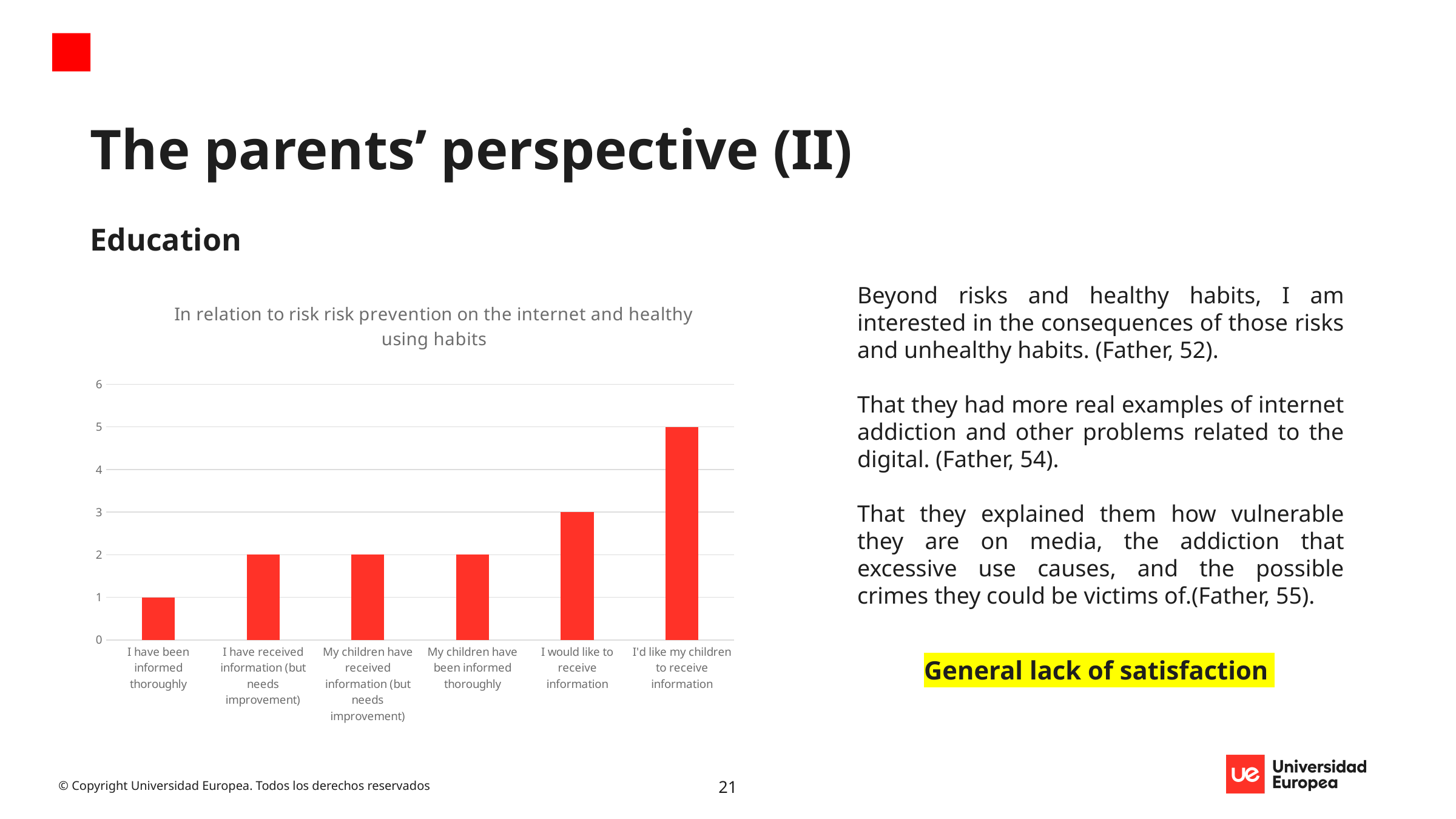
What is the difference between the values for "I'd like my children to receive information" and "I would like to receive information"? 2 What is the value for "I have been informed thoroughly"? 1 What is the title of the chart? In relation to risk risk prevention on the internet and healthy using habits How many categories are shown on the x axis of the chart? 6 What is the value for "I'd like my children to receive information"? 5 Which category has the lowest value? I have been informed thoroughly Which is larger: the value for "I would like to receive information" or the value for "I have received information (but needs improvement)"? I would like to receive information What type of chart is shown on the slide? Bar chart What is the value for "I would like to receive information"? 3 Which category has the highest value? I'd like my children to receive information Is the value for "I'd like my children to receive information" greater or less than 4? greater What is the value for "My children have been informed thoroughly"? 2